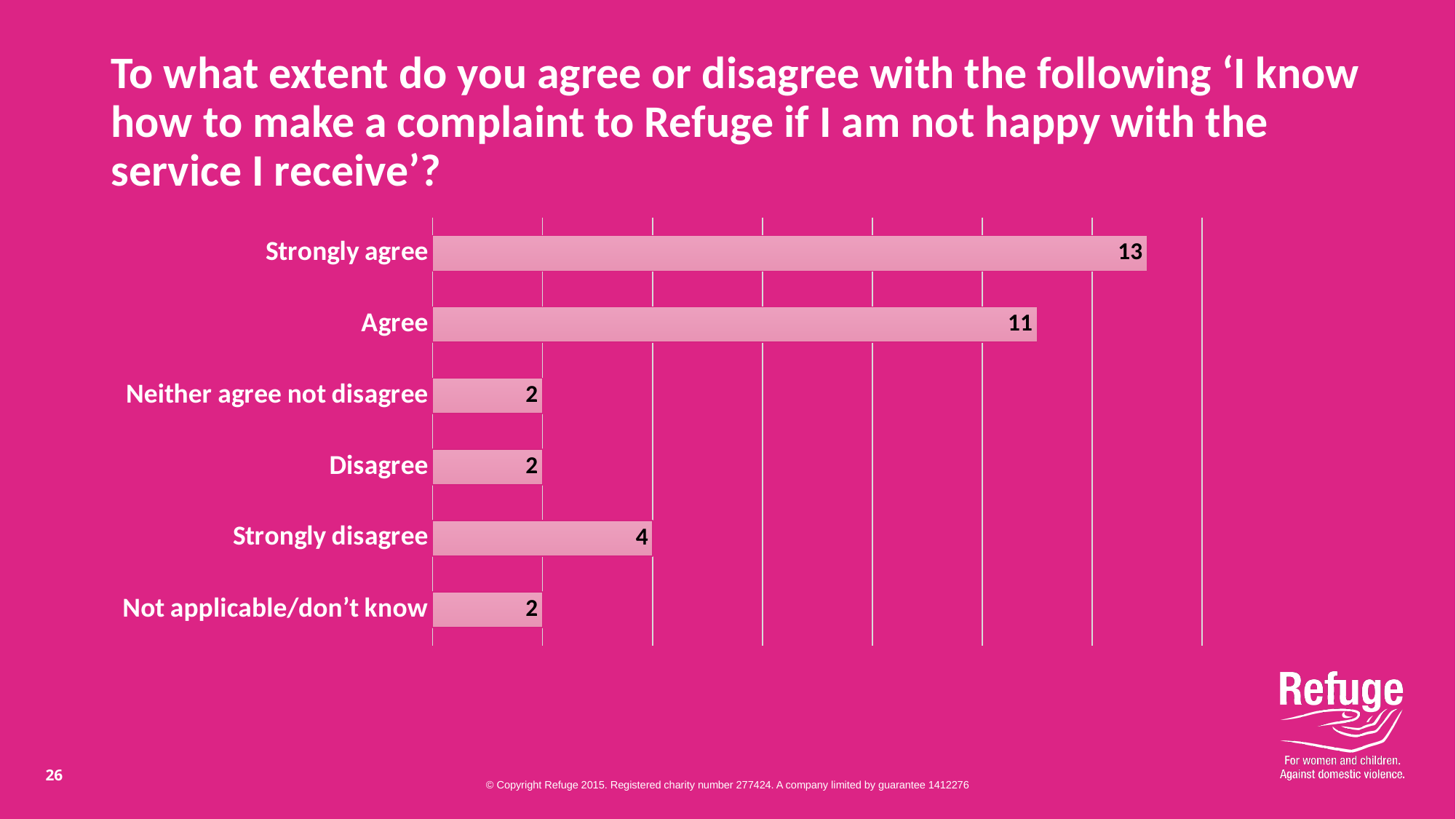
Which is larger, the value for Strongly disagree or the value for Disagree? Strongly disagree How many categories are shown in the chart? 6 What is the value for Strongly agree? 13 What is the difference between the values for Strongly agree and Agree? 2 What kind of chart is shown on the slide? Bar chart How many categories have a value of 2? 3 What is the value for Not applicable/don't know? 2 What is the value for Agree? 11 What is the difference between the values for Agree and Strongly disagree? 7 What is the value for Strongly disagree? 4 What is the total of all the values shown in the chart? 34 Which category has the highest value? Strongly agree